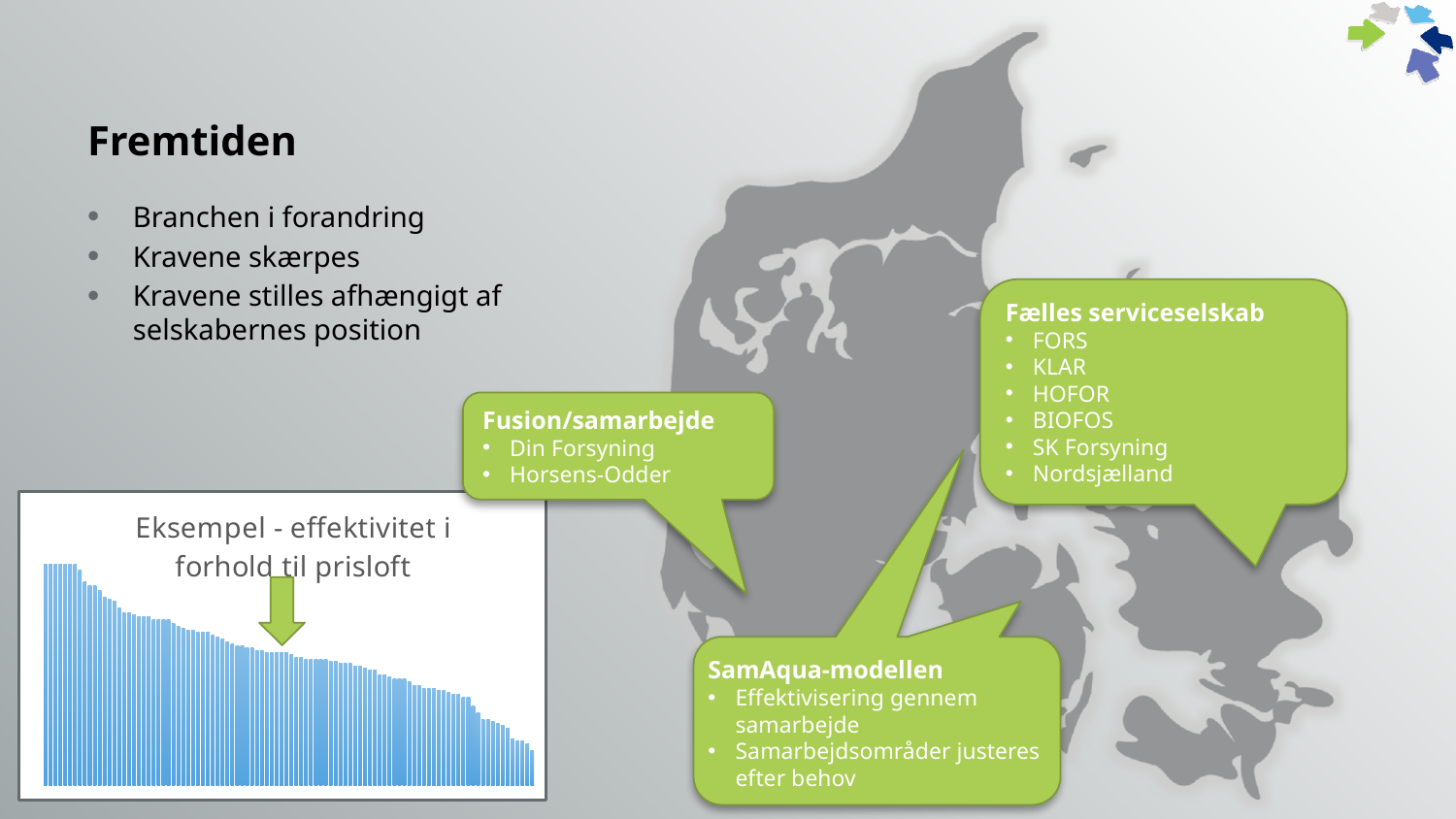
Does the chart show a legend? no What colour are the bars in the chart? blue What is the title of the chart on the slide? Eksempel - effektivitet i forhold til prisloft Are the bars on the left side of the chart taller or shorter than the bars on the right side? taller What kind of chart is shown on the slide? bar chart Do the bar heights rise or fall from left to right across the chart? fall